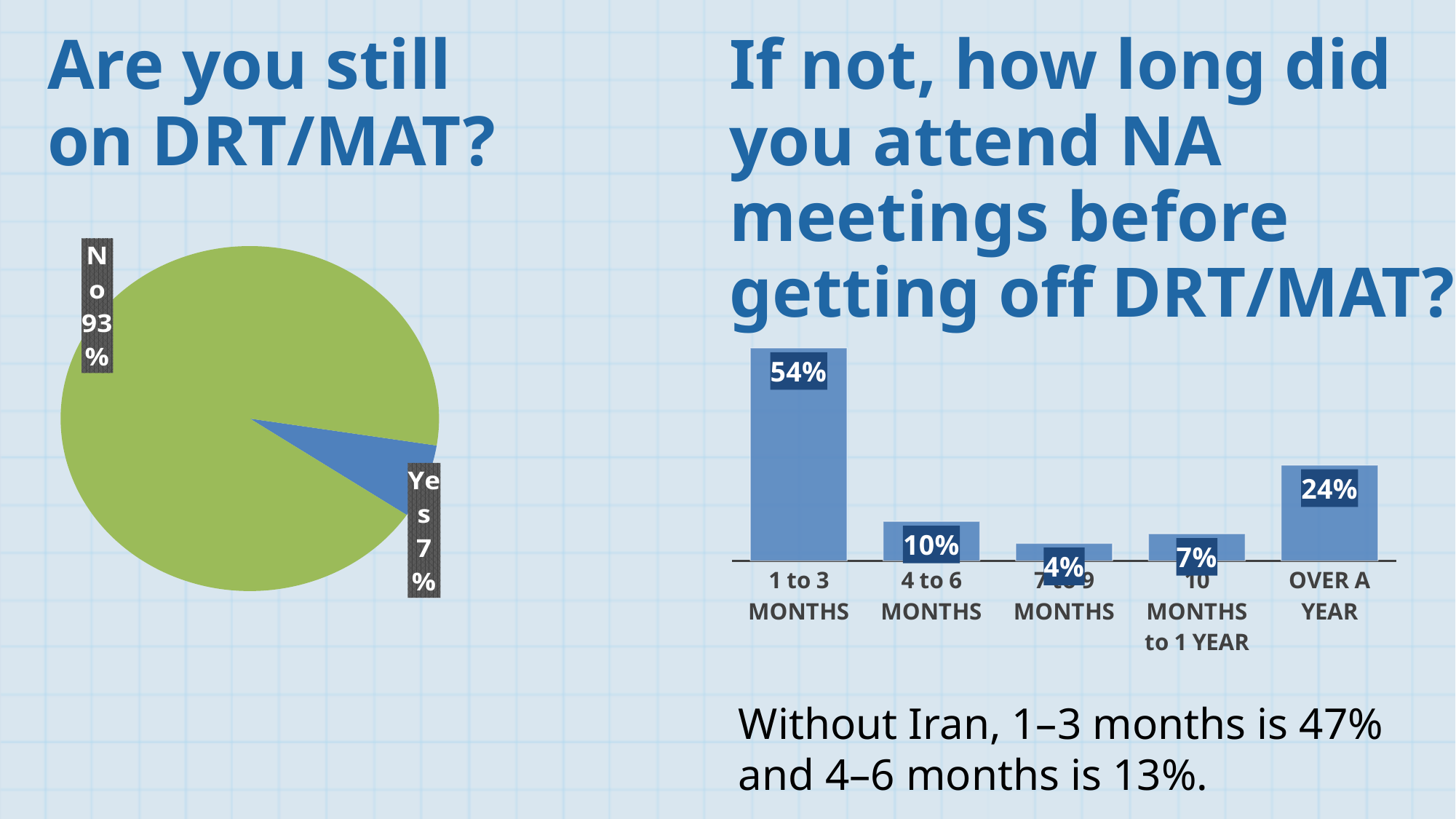
In the 'If not, how long did you attend NA meetings before getting off DRT/MAT?' chart, which category has the highest value? 1 to 3 months In the 'Are you still on DRT/MAT?' chart, what percentage answered Yes? 7% What kind of chart is the 'If not, how long did you attend NA meetings before getting off DRT/MAT?' chart? bar chart How many categories are shown in the 'If not, how long did you attend NA meetings before getting off DRT/MAT?' chart? 5 In the 'If not, how long did you attend NA meetings before getting off DRT/MAT?' chart, what is the difference between 1 to 3 months and over a year? 30% In the 'If not, how long did you attend NA meetings before getting off DRT/MAT?' chart, what is the value for 1 to 3 months? 54% In the 'Are you still on DRT/MAT?' chart, what colour is the No slice? green In the 'If not, how long did you attend NA meetings before getting off DRT/MAT?' chart, what is the value for over a year? 24% What kind of chart is the 'Are you still on DRT/MAT?' chart? pie chart In the 'Are you still on DRT/MAT?' chart, which answer has the larger share? No In the 'If not, how long did you attend NA meetings before getting off DRT/MAT?' chart, which category has the lowest value? 7 to 9 months In the 'Are you still on DRT/MAT?' chart, what percentage answered No? 93%